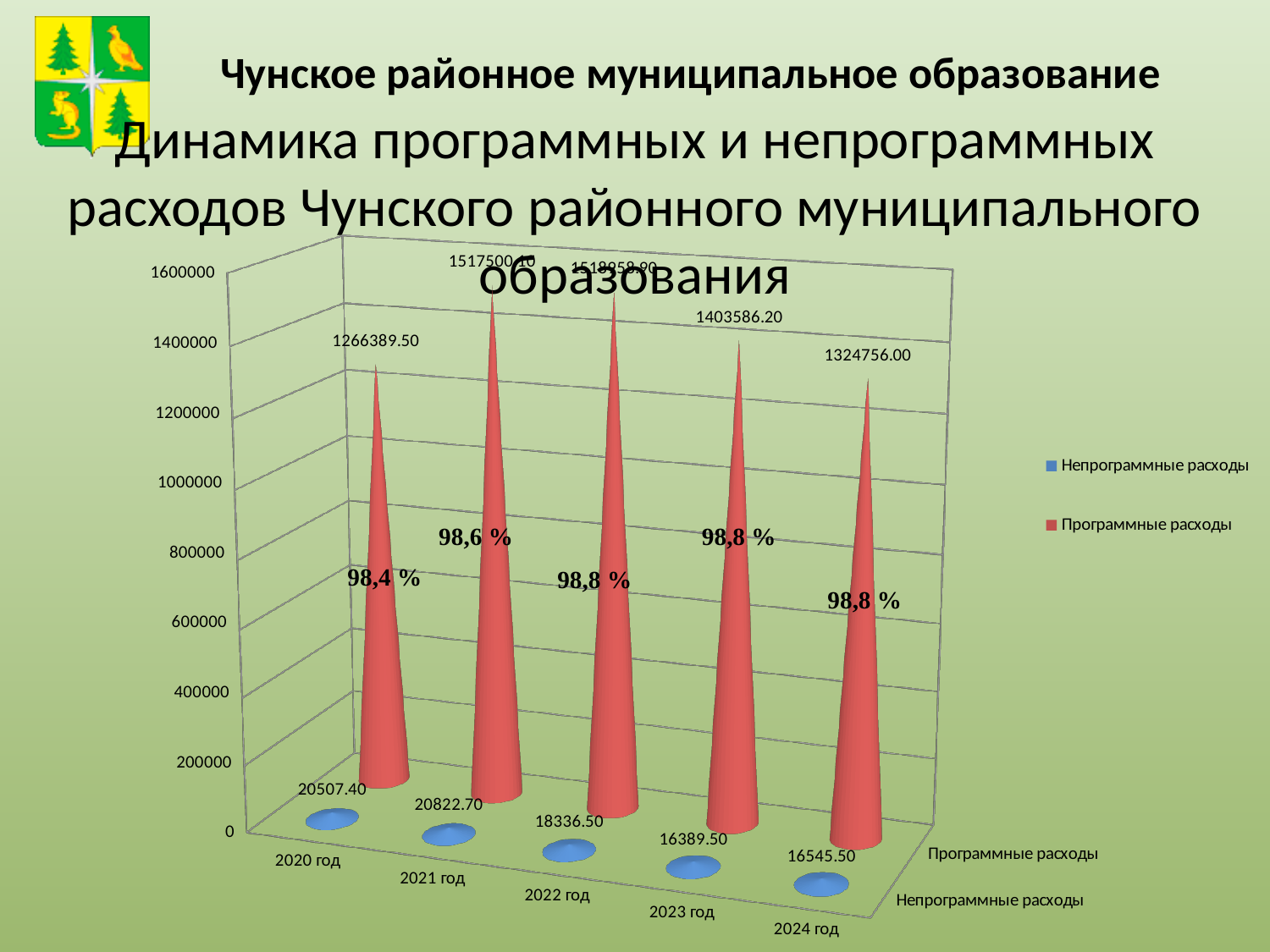
What is the value of Программные расходы for 2024 год? 1324756.00 What is the value of Программные расходы for 2020 год? 1266389.50 How many years are shown on the x axis? 5 Is the value of Программные расходы for 2024 год greater or less than 1400000? less What is the value of Непрограммные расходы for 2022 год? 18336.50 Which is larger: Программные расходы in 2023 год or in 2024 год? 2023 год How many series does the legend list? 2 What is the value of Программные расходы for 2023 год? 1403586.20 What is the value of Непрограммные расходы for 2020 год? 20507.40 In which year is the value of Программные расходы the lowest? 2020 год What is the difference between Программные расходы in 2023 год and 2024 год? 78830.20 What percentage label is shown for 2020 год? 98,4 %